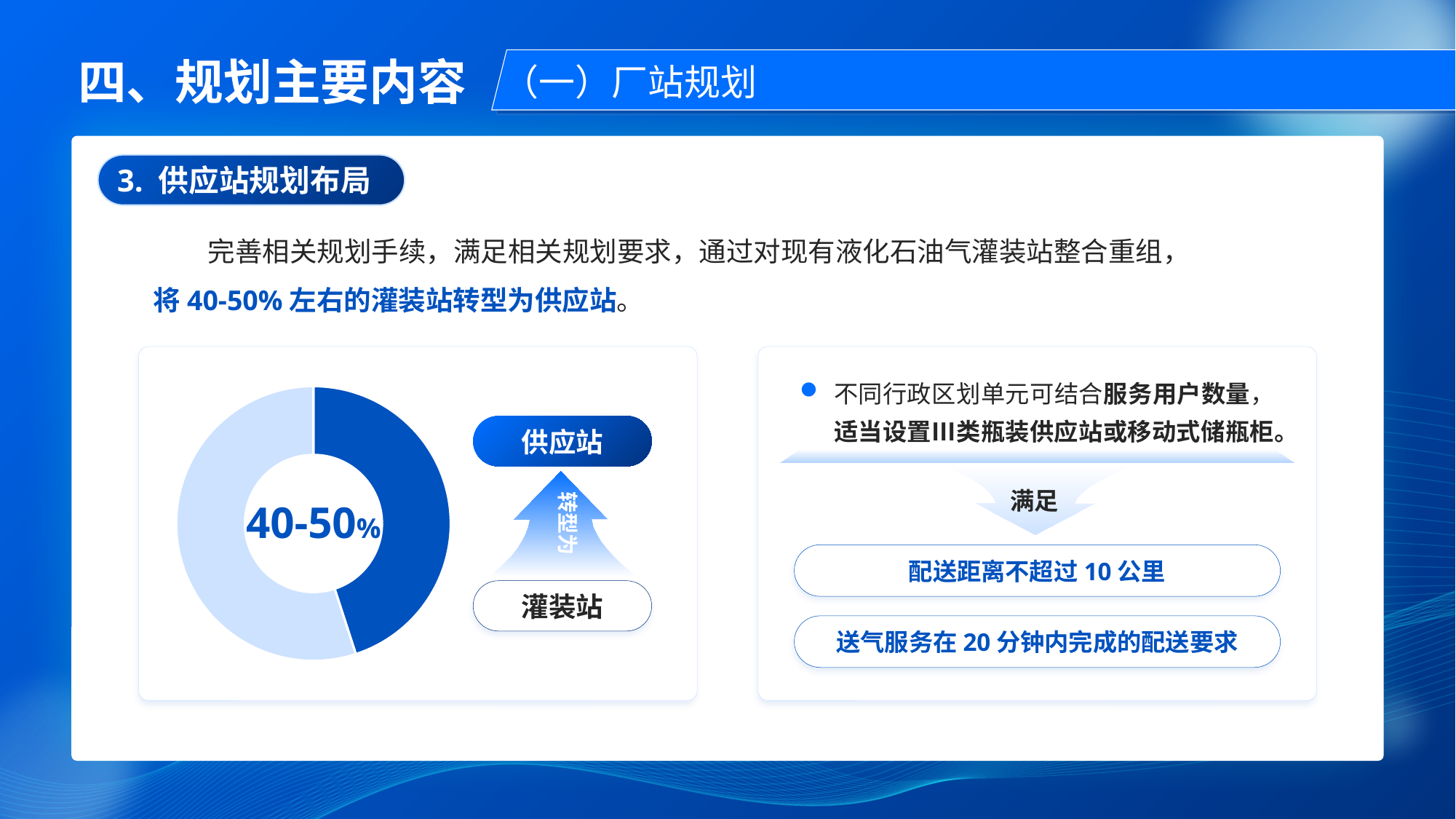
What kind of chart is shown on the left side of the slide? donut (pie) chart What value is printed in the centre of the donut chart? 40-50% What label is shown in the white box below the arrow next to the donut chart? 灌装站 What label is shown in the dark blue box above the arrow next to the donut chart? 供应站 What share of filling stations does the donut chart indicate will be converted to supply stations? 40-50% How many slices does the donut chart have? 2